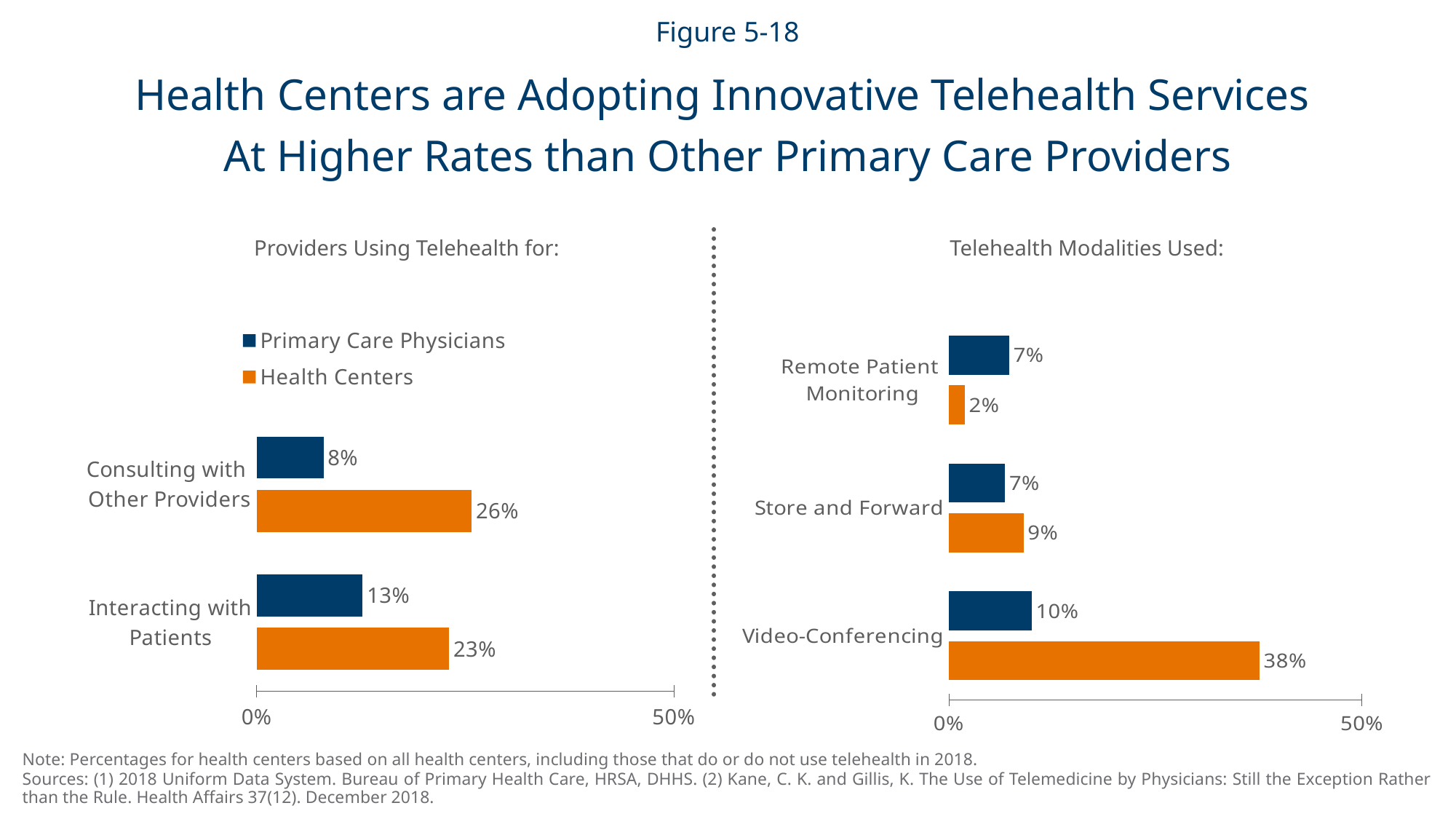
In the 'Telehealth Modalities Used:' chart, what is the value for Health Centers for Video-Conferencing? 38% What kind of chart is the 'Providers Using Telehealth for:' chart? Bar chart In the 'Telehealth Modalities Used:' chart, what is the difference between Health Centers and Primary Care Physicians for Video-Conferencing? 28% In the 'Telehealth Modalities Used:' chart, which modality has the lowest value for Health Centers? Remote Patient Monitoring In the 'Providers Using Telehealth for:' chart, what is the value for Health Centers for Consulting with Other Providers? 26% In the 'Telehealth Modalities Used:' chart, which modality has the highest value for Health Centers? Video-Conferencing In the 'Telehealth Modalities Used:' chart, for Remote Patient Monitoring, which is larger: Primary Care Physicians or Health Centers? Primary Care Physicians How many categories are shown in the 'Telehealth Modalities Used:' chart? 3 How many series does the legend list? 2 In the 'Providers Using Telehealth for:' chart, what is the difference between Health Centers and Primary Care Physicians for Consulting with Other Providers? 18% In the 'Telehealth Modalities Used:' chart, what is the value for Health Centers for Remote Patient Monitoring? 2% In the 'Providers Using Telehealth for:' chart, what is the value for Primary Care Physicians for Interacting with Patients? 13%